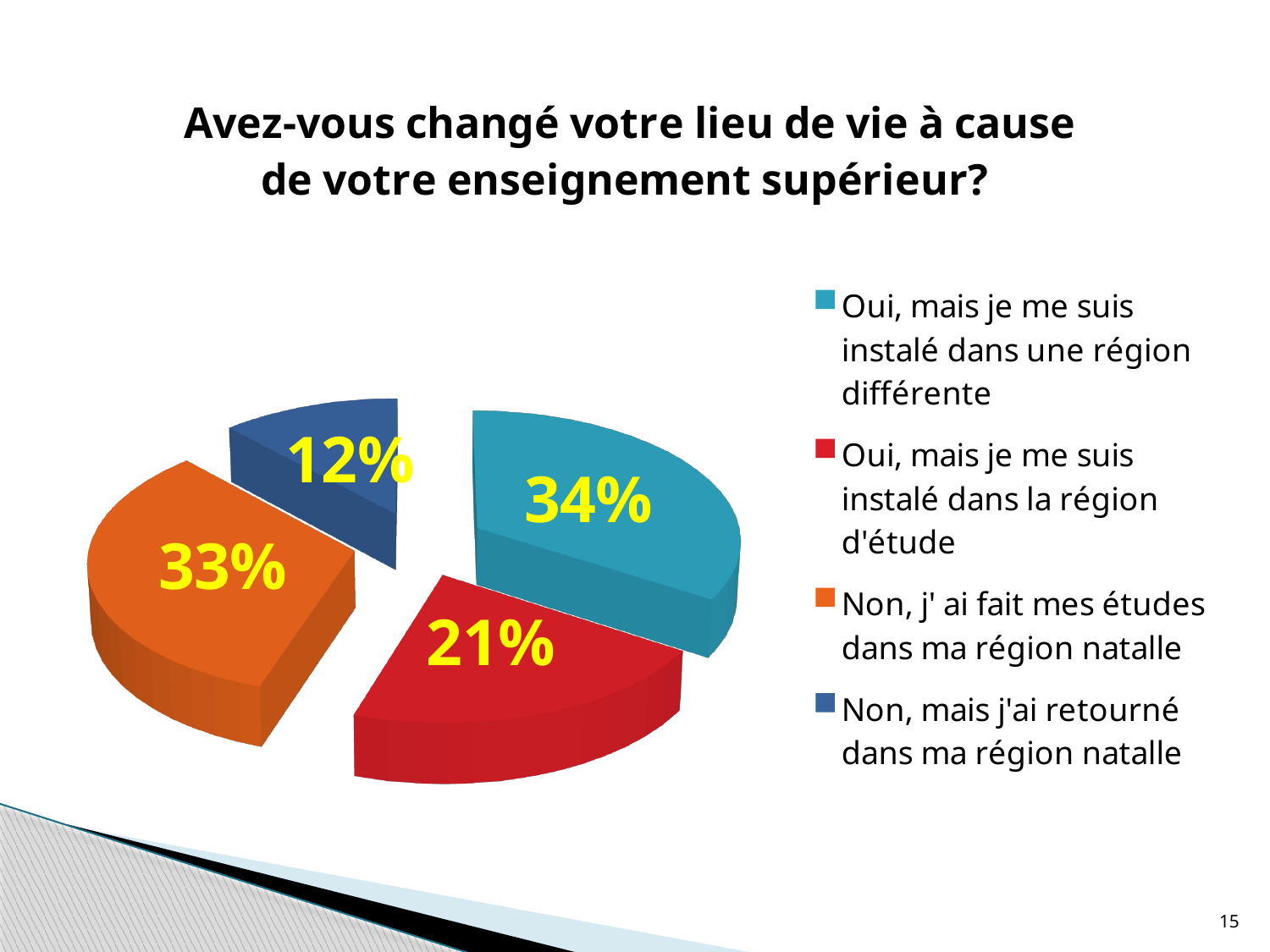
How many slices does the pie chart have? 4 What is the title of the chart? Avez-vous changé votre lieu de vie à cause de votre enseignement supérieur? What is the difference in percentage points between "Non, j' ai fait mes études dans ma région natalle" and "Non, mais j'ai retourné dans ma région natalle"? 21 What colour is the slice for "Non, j' ai fait mes études dans ma région natalle"? Orange Which is larger: the share for "Oui, mais je me suis instalé dans la région d'étude" or the share for "Non, mais j'ai retourné dans ma région natalle"? Oui, mais je me suis instalé dans la région d'étude What kind of chart is shown on the slide? Pie chart What percentage is shown for "Oui, mais je me suis instalé dans la région d'étude"? 21% What percentage is shown for "Non, mais j'ai retourné dans ma région natalle"? 12% What share of the pie does "Oui, mais je me suis instalé dans une région différente" represent? 34% Which category has the largest share of the pie? Oui, mais je me suis instalé dans une région différente What percentage is shown for "Non, j' ai fait mes études dans ma région natalle"? 33% Which category has the smallest share of the pie? Non, mais j'ai retourné dans ma région natalle